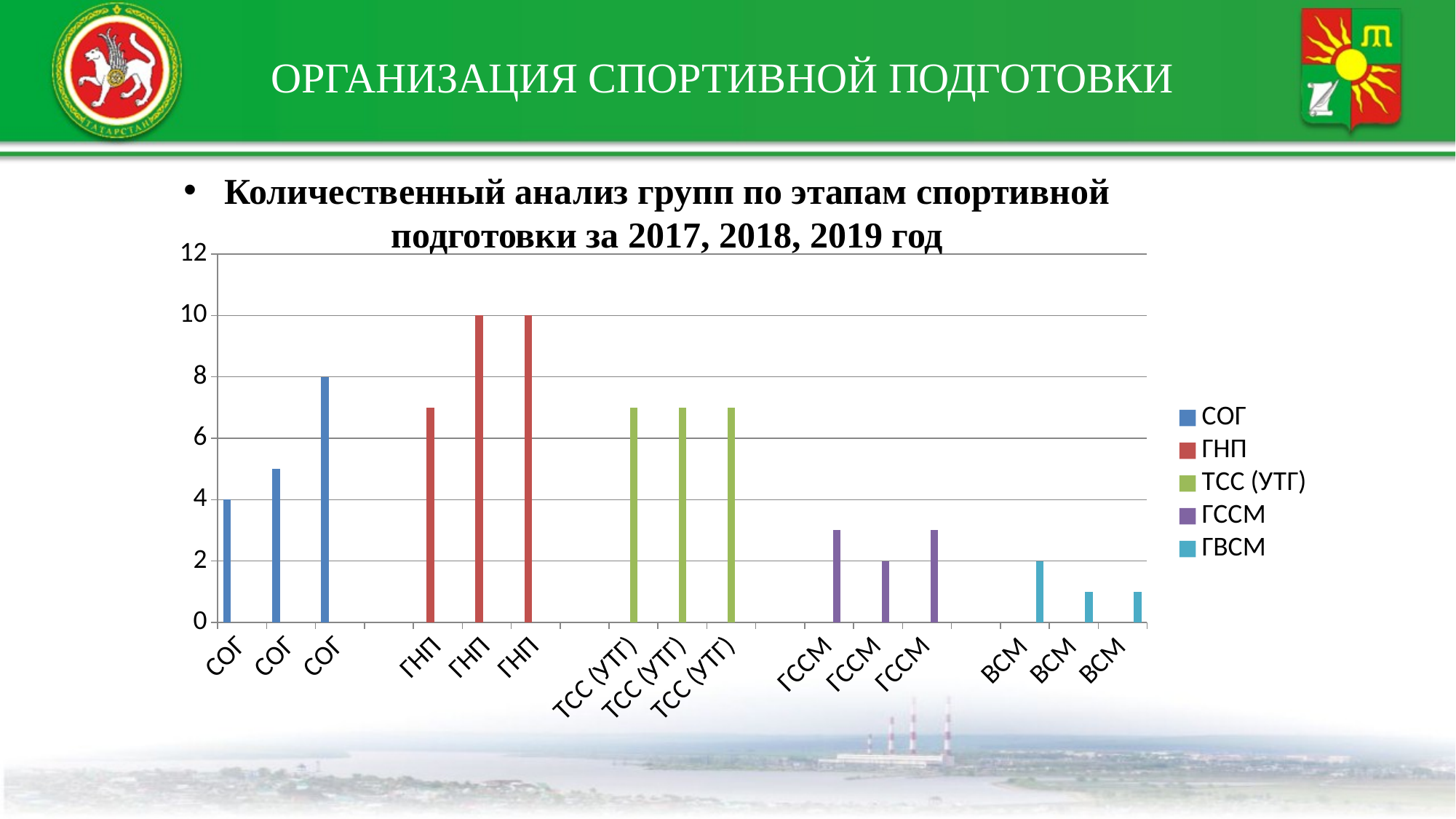
Is the value of the second ГССМ bar greater or less than 4? less What kind of chart is shown on the slide? Bar chart How many bars are plotted on the chart? 15 What is the value of the third (rightmost) СОГ bar? 8 What is the value of the first (leftmost) ВСМ bar? 2 What is the value of the second ГНП bar? 10 Which is larger: the first СОГ bar or the first ГНП bar? The first ГНП bar Which series has the tallest bars on the chart? ГНП Do the three СОГ bars rise or fall from left to right? Rise How many series does the legend list? 5 Is the value of the first ГНП bar greater or less than 6? greater What is the difference between the third СОГ bar and the first СОГ bar? 4